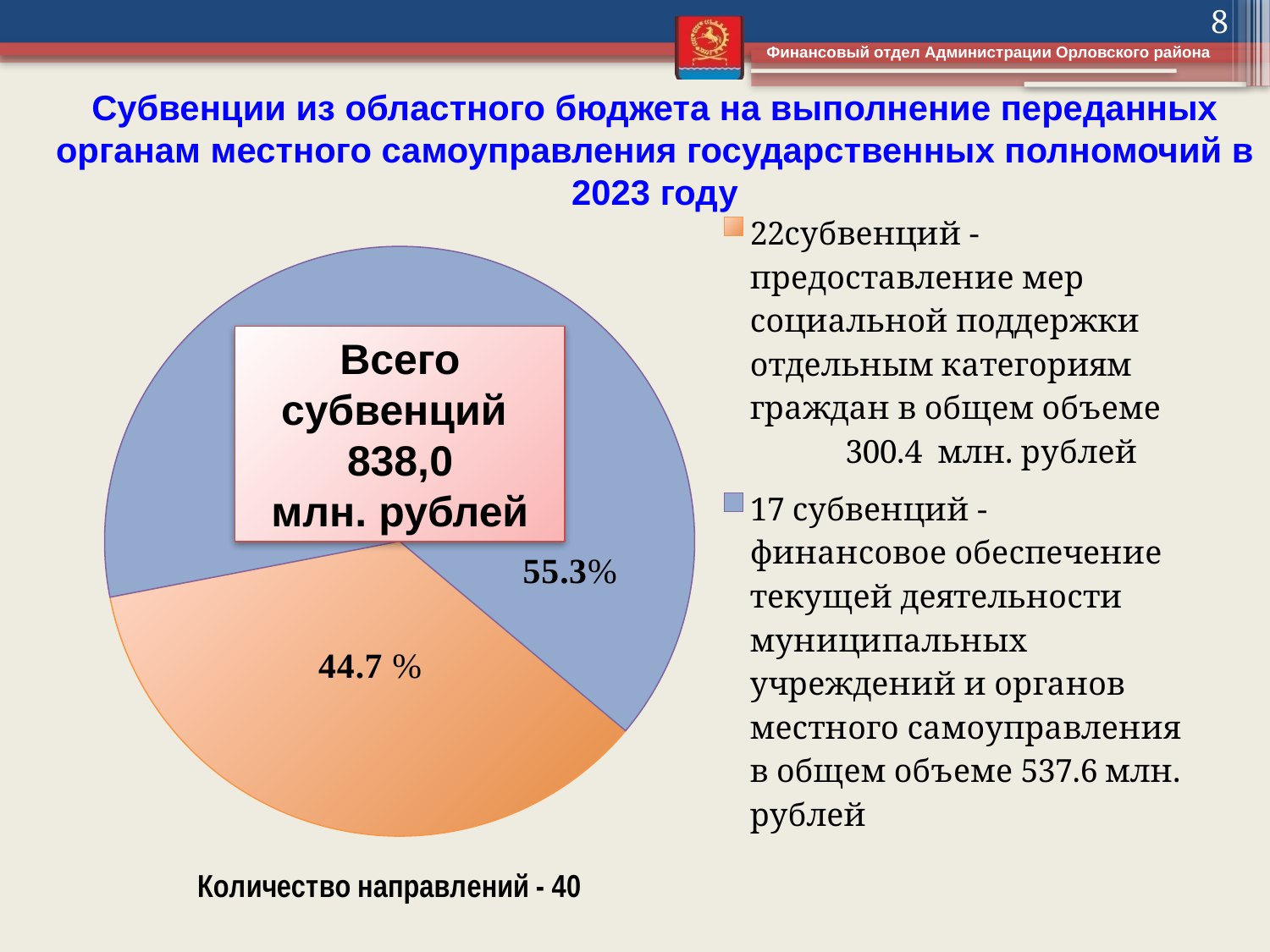
What is the difference in percentage points between the blue slice and the orange slice? 10.6 Which slice of the pie is larger, the blue one or the orange one? blue How many directions (направлений) are stated below the pie chart? 40 How many slices does the pie chart have? 2 What type of chart is shown on the slide? pie chart According to the legend, what is the total volume of the 17 subventions for financial support of municipal institutions (blue slice)? 537.6 млн. рублей What share of the pie does the orange slice represent? 44.7 % How many legend entries are listed to the right of the pie chart? 2 According to the legend, what is the total volume of the 22 subventions for social support measures (orange slice)? 300.4 млн. рублей Is the share of the orange slice greater or less than 50%? less What is the total amount of subventions shown in the centre of the pie chart? 838,0 млн. рублей What share of the pie does the blue slice represent? 55.3%